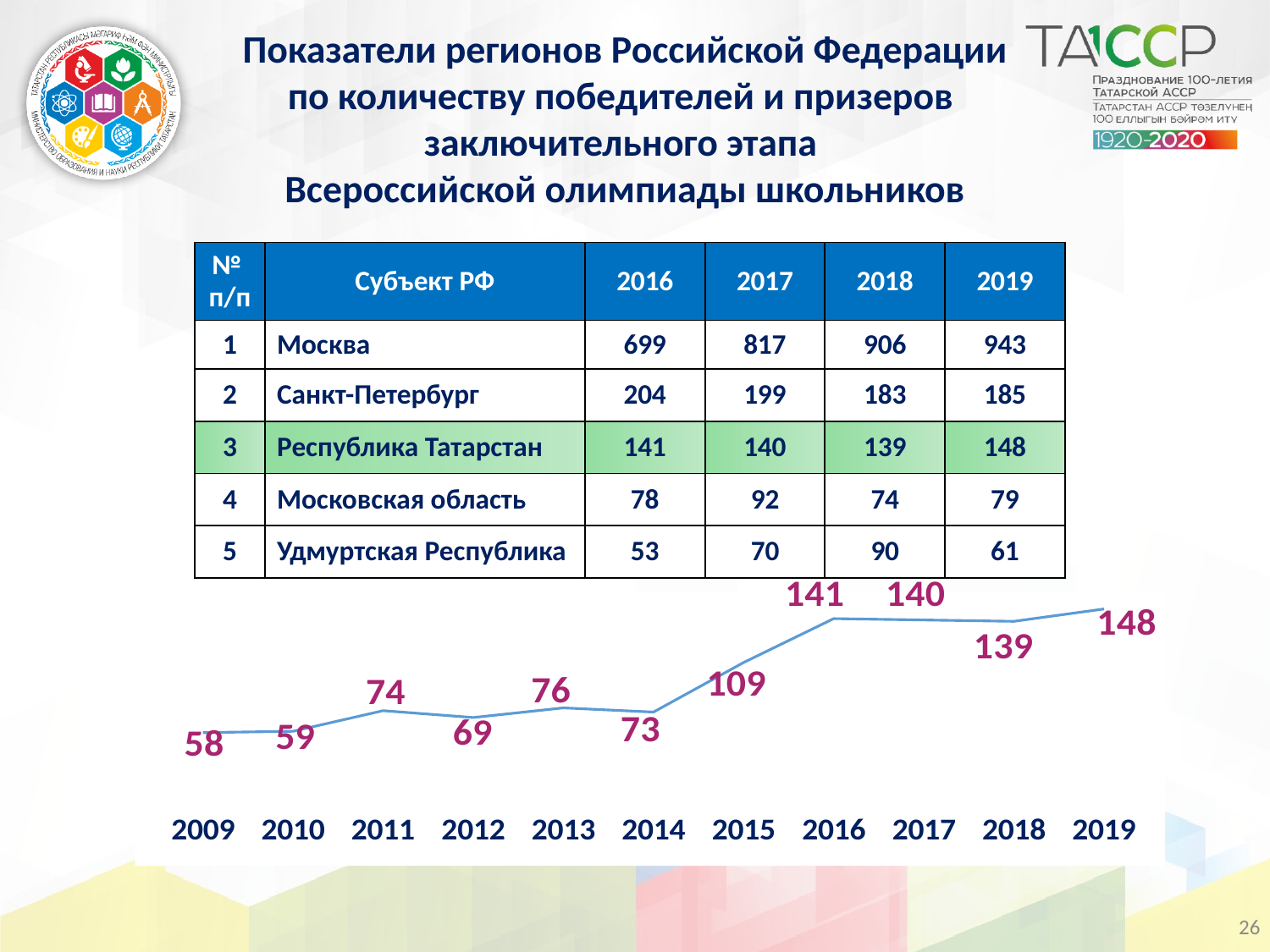
In the line chart, do the values generally rise or fall from 2009 to 2019? rise In the line chart, which is larger, the value for 2011 or the value for 2014? 2011 In the line chart, what is the difference between the values for 2016 and 2015? 32 In the line chart, what is the value for 2009? 58 In the line chart, what is the value for 2019? 148 In the line chart, what is the value for 2015? 109 What kind of chart is shown at the bottom of the slide? line chart In the line chart, what is the value for 2012? 69 How many years are plotted on the x axis of the line chart? 11 In the line chart, what is the difference between the values for 2019 and 2009? 90 In the line chart, which year has the lowest value? 2009 In the line chart, which year has the highest value? 2019